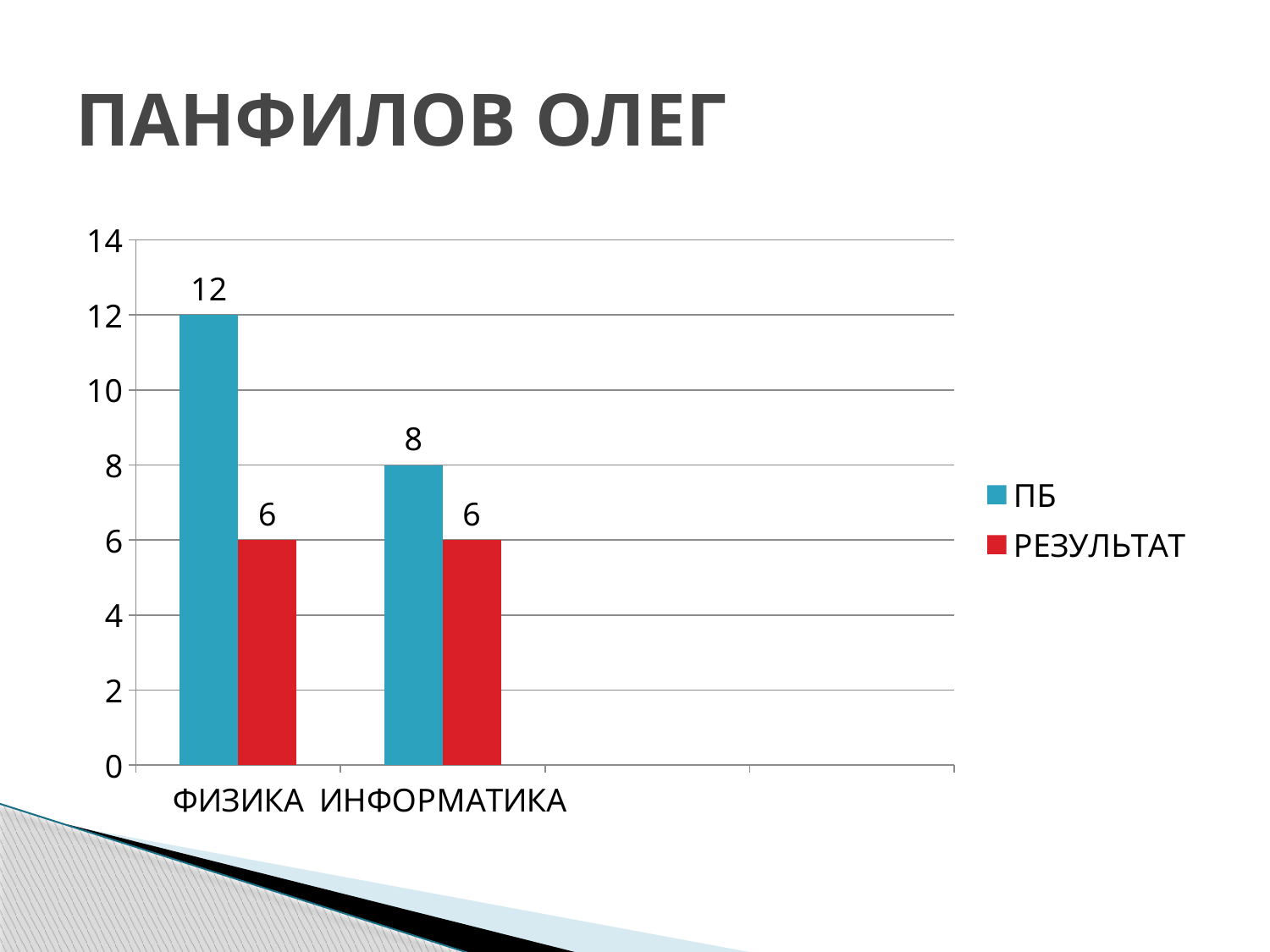
Which category has the lowest ПБ value? ИНФОРМАТИКА How many series does the legend list? 2 What is the ПБ value for ИНФОРМАТИКА? 8 Which category has the highest ПБ value? ФИЗИКА What kind of chart is shown on the slide? bar chart What colour are the РЕЗУЛЬТАТ bars? red Which is larger for ИНФОРМАТИКА, the ПБ value or the РЕЗУЛЬТАТ value? ПБ How many categories are shown on the x axis? 2 What is the difference between the ПБ values for ФИЗИКА and ИНФОРМАТИКА? 4 What is the ПБ value for ФИЗИКА? 12 What is the difference between the ПБ and РЕЗУЛЬТАТ values for ФИЗИКА? 6 What is the РЕЗУЛЬТАТ value for ИНФОРМАТИКА? 6